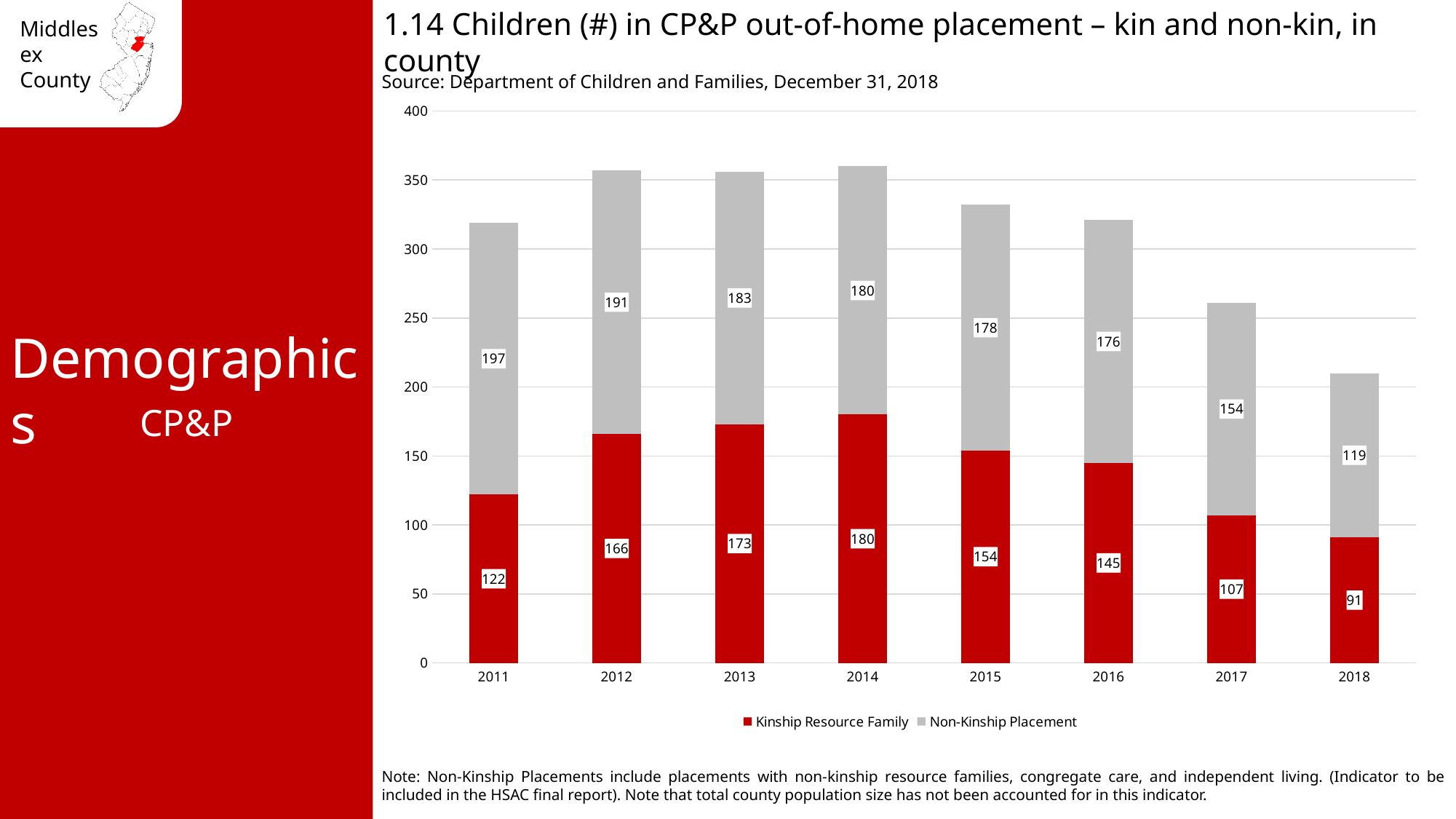
What is the total of the stacked bar for 2017? 261 What is the Kinship Resource Family value for 2014? 180 Which year has the highest Non-Kinship Placement value? 2011 What is the difference between the Non-Kinship Placement values for 2012 and 2018? 72 What is the total of the stacked bar for 2014? 360 Does the Kinship Resource Family value rise or fall from 2014 to 2018? Fall How many years are shown on the x axis? 8 What is the Non-Kinship Placement value for 2011? 197 What kind of chart is shown? Stacked bar chart Which is larger, the Kinship Resource Family value for 2013 or for 2016? 2013 Which year has the lowest Kinship Resource Family value? 2018 How many series does the legend list? 2